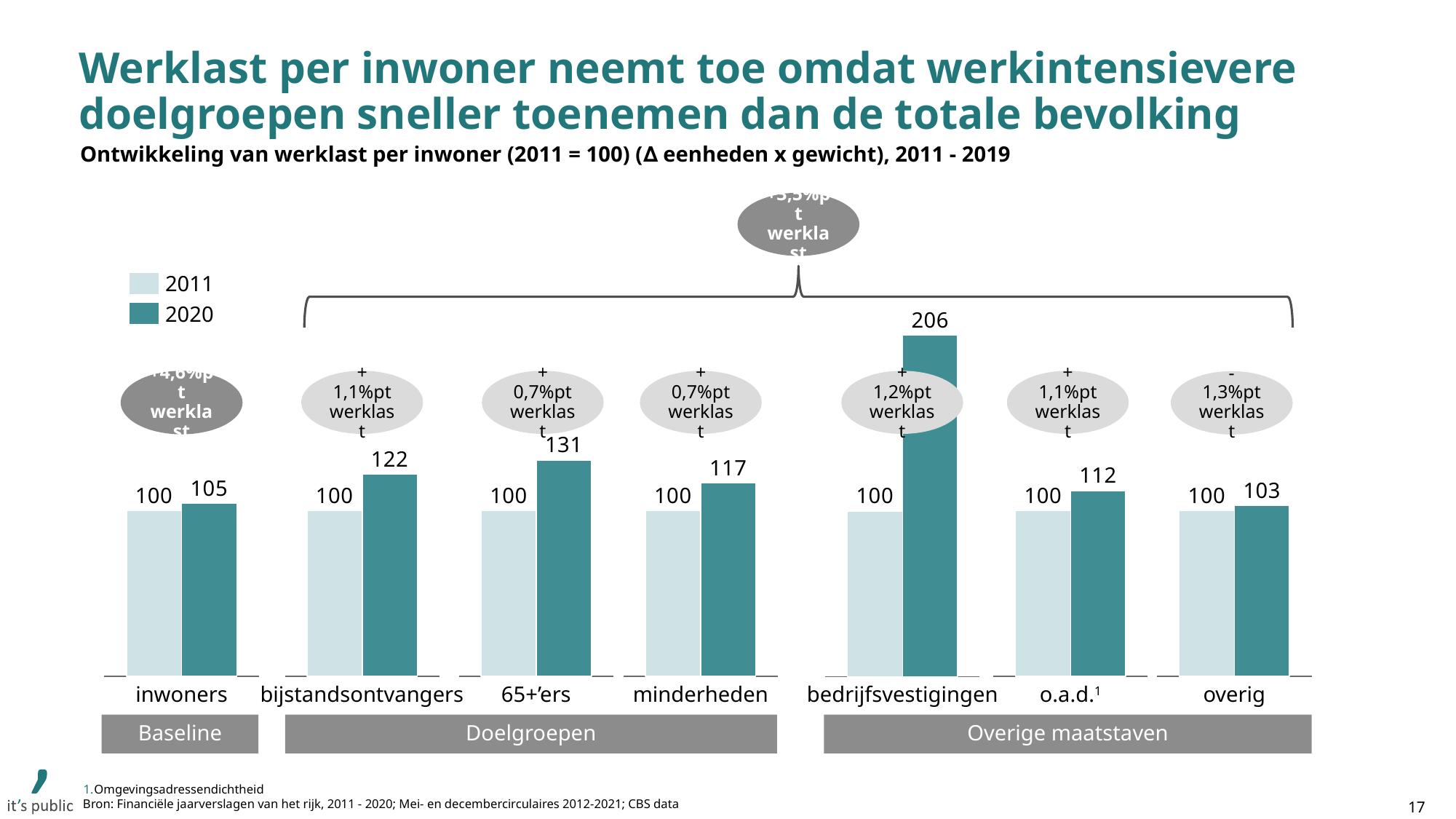
What is the 2020 value for bedrijfsvestigingen? 206 What is the 2020 value for 65+'ers? 131 How many categories are shown on the x axis? 7 How many series does the legend list? 2 What kind of chart is shown on the slide? bar chart Which category has the highest 2020 value? bedrijfsvestigingen Which category has the lowest 2020 value? overig Which is larger: the 2020 value for o.a.d. or the 2020 value for minderheden? minderheden Which years are listed in the legend? 2011 and 2020 What is the difference between the 2020 value for bijstandsontvangers and the 2020 value for inwoners? 17 What is the 2011 value for minderheden? 100 What is the 2020 value for inwoners? 105